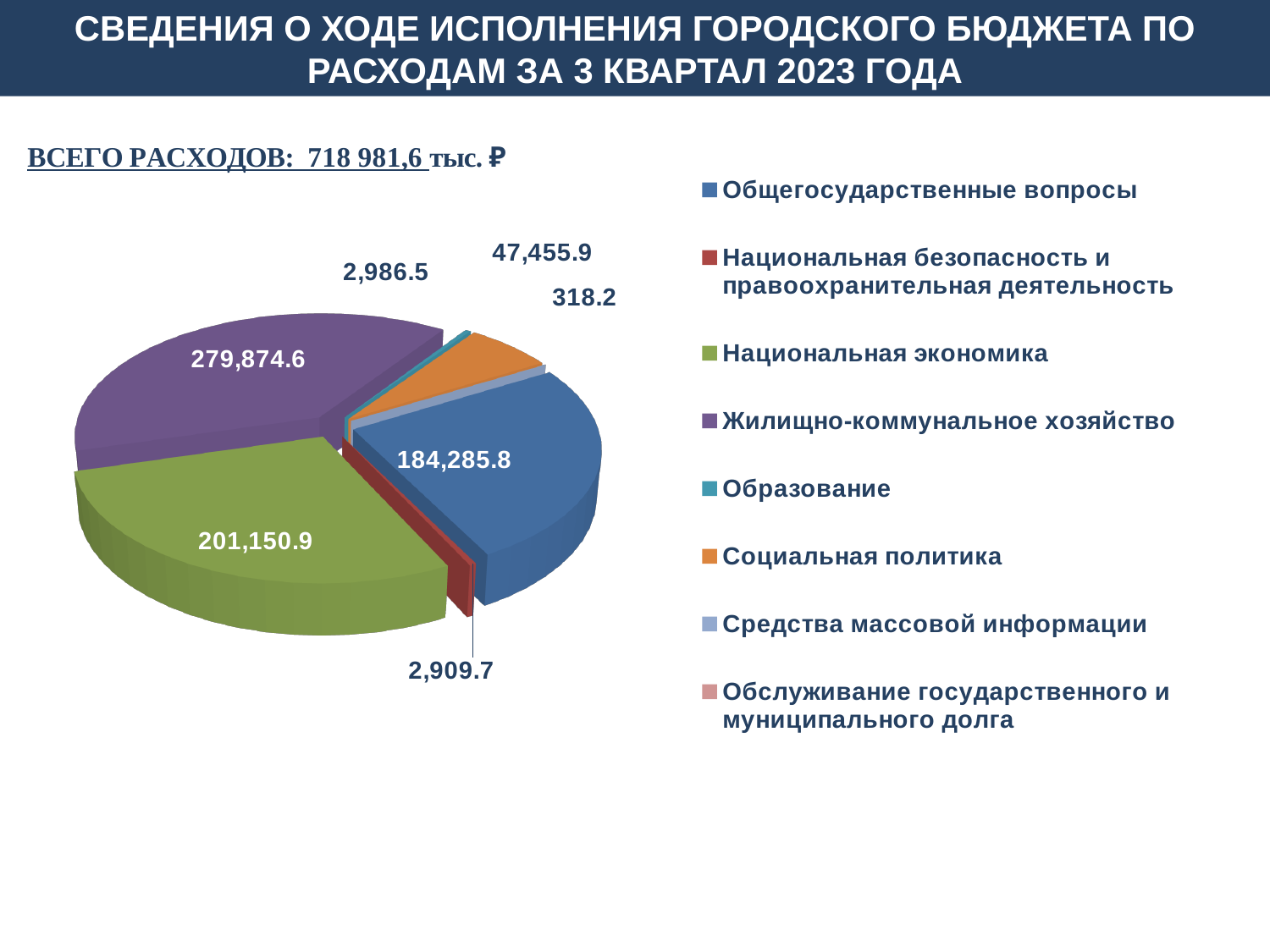
What is the value for Жилищно-коммунальное хозяйство? 279,874.6 What is the value for Национальная экономика? 201,150.9 What kind of chart is shown on the slide? Pie chart How many categories does the legend of the pie chart list? 8 What is the value for Социальная политика? 47,455.9 What is the value for Общегосударственные вопросы? 184,285.8 What is the difference between the values for Жилищно-коммунальное хозяйство and Национальная экономика? 78,723.7 Which is larger: Общегосударственные вопросы or Национальная экономика? Национальная экономика What is the value for Образование? 2,986.5 What is the value for Национальная безопасность и правоохранительная деятельность? 2,909.7 Which category has the largest slice of the pie? Жилищно-коммунальное хозяйство What total expenditure (ВСЕГО РАСХОДОВ) is stated on the slide? 718 981,6 тыс. ₽